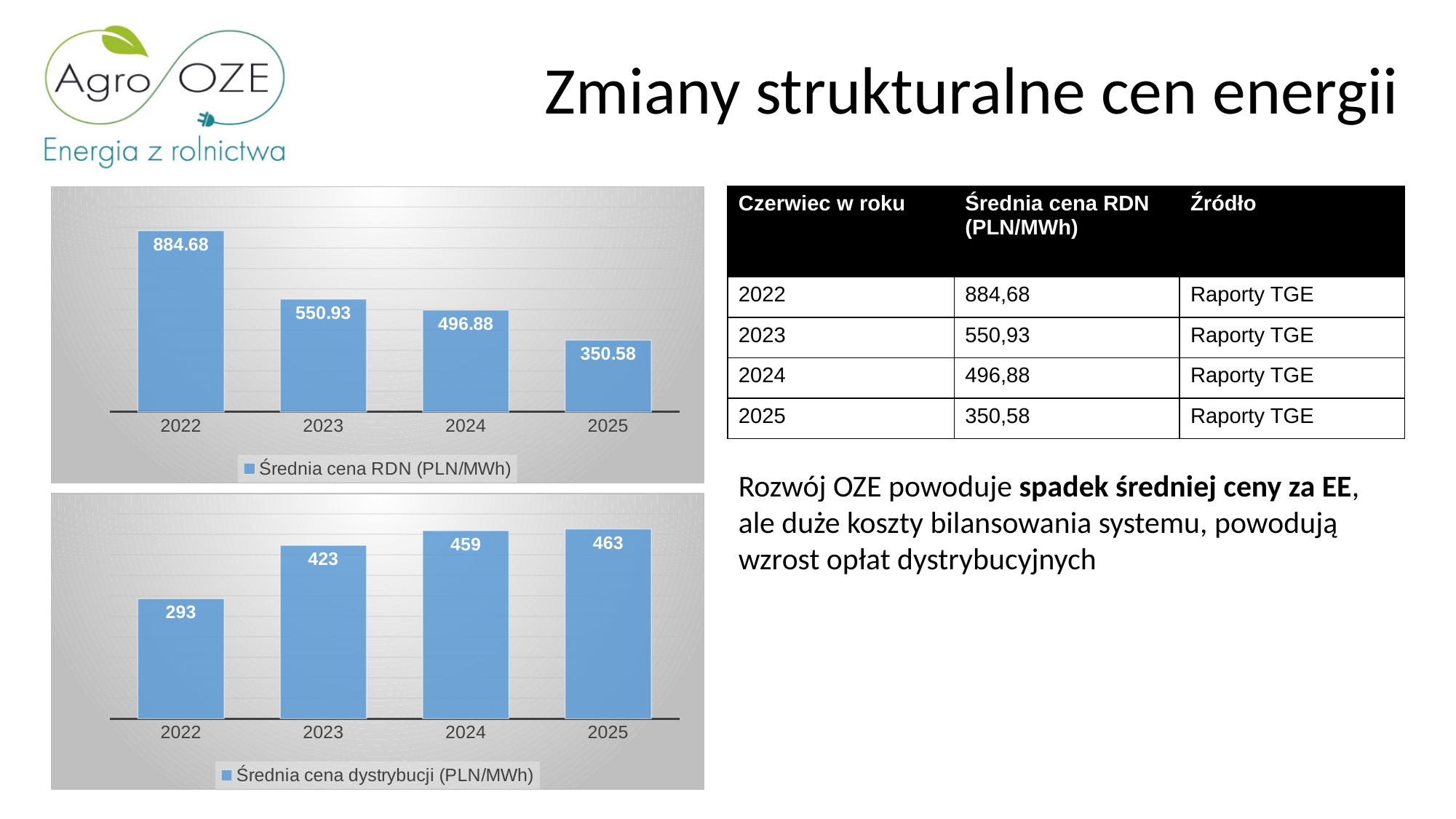
In the top chart (Średnia cena RDN), what is the value for 2025? 350.58 In the top chart (Średnia cena RDN), what is the difference between the 2023 and 2024 values? 54.05 In the bottom chart (Średnia cena dystrybucji), which year has the lowest value? 2022 How many years are shown on the x axis of the top chart (Średnia cena RDN)? 4 In the bottom chart (Średnia cena dystrybucji), which is larger, the value for 2023 or the value for 2024? 2024 In the top chart (Średnia cena RDN), do the values rise or fall from 2022 to 2025? fall What kind of chart is the bottom chart (Średnia cena dystrybucji)? bar chart What is the legend entry of the bottom chart? Średnia cena dystrybucji (PLN/MWh) In the top chart (Średnia cena RDN), which year has the highest value? 2022 In the top chart (Średnia cena RDN), what is the value for 2022? 884.68 In the bottom chart (Średnia cena dystrybucji), what is the difference between the 2025 and 2022 values? 170 In the bottom chart (Średnia cena dystrybucji), what is the value for 2023? 423